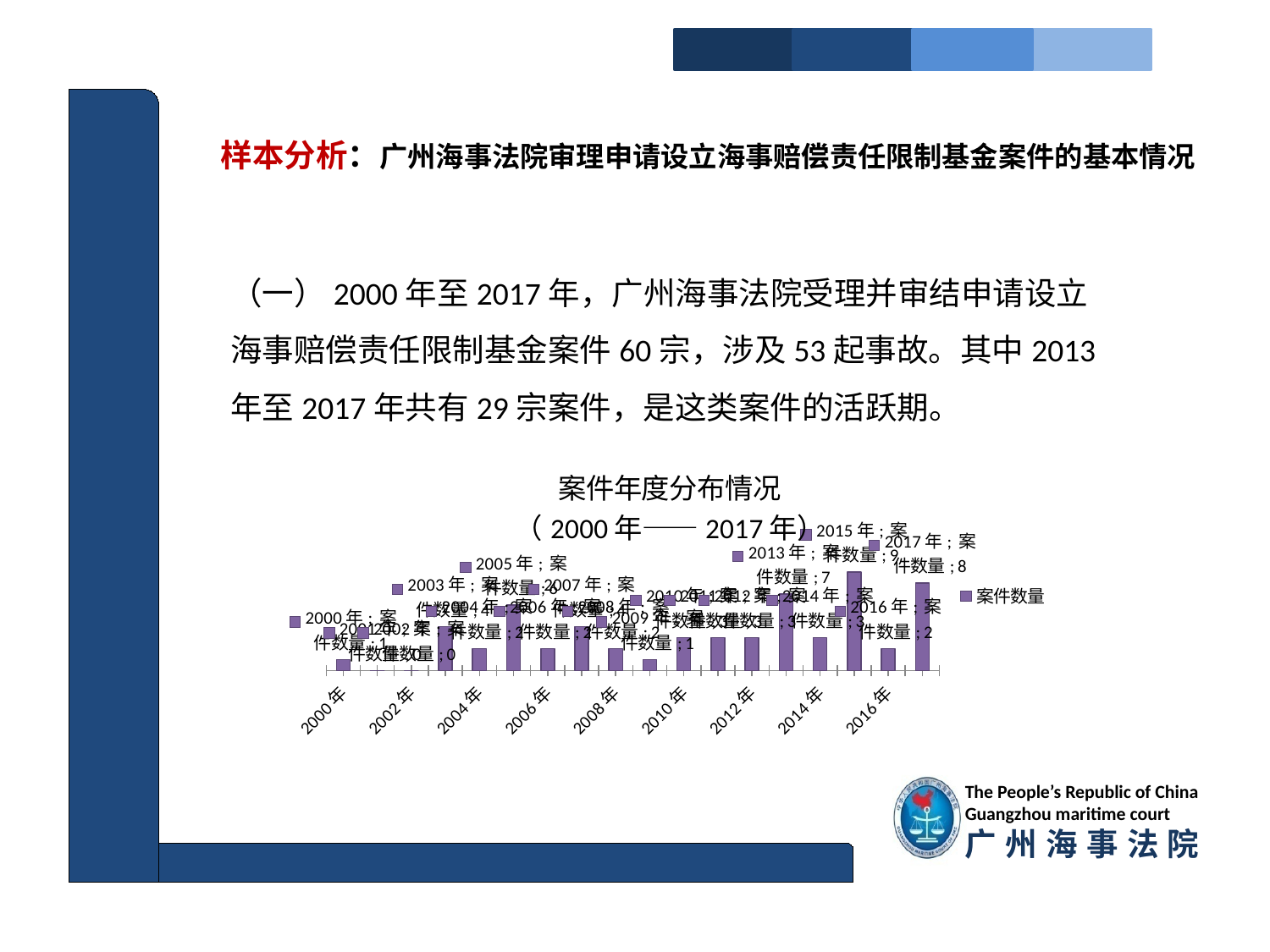
What is the number of cases (案件数量) for 2015年? 9 What is the title of the chart? 案件年度分布情况（2000年——2017年） Which year has the highest number of cases (案件数量)? 2015年 Which year has more cases, 2015年 or 2017年? 2015年 What is the number of cases (案件数量) for 2005年? 6 What is the name of the series shown in the legend? 案件数量 What is the difference in the number of cases between 2015年 and 2017年? 1 What is the number of cases (案件数量) for 2017年? 8 What kind of chart is shown on the slide? bar chart What is the number of cases (案件数量) for 2013年? 7 How many series does the chart legend list? 1 What is the number of cases (案件数量) for 2016年? 2